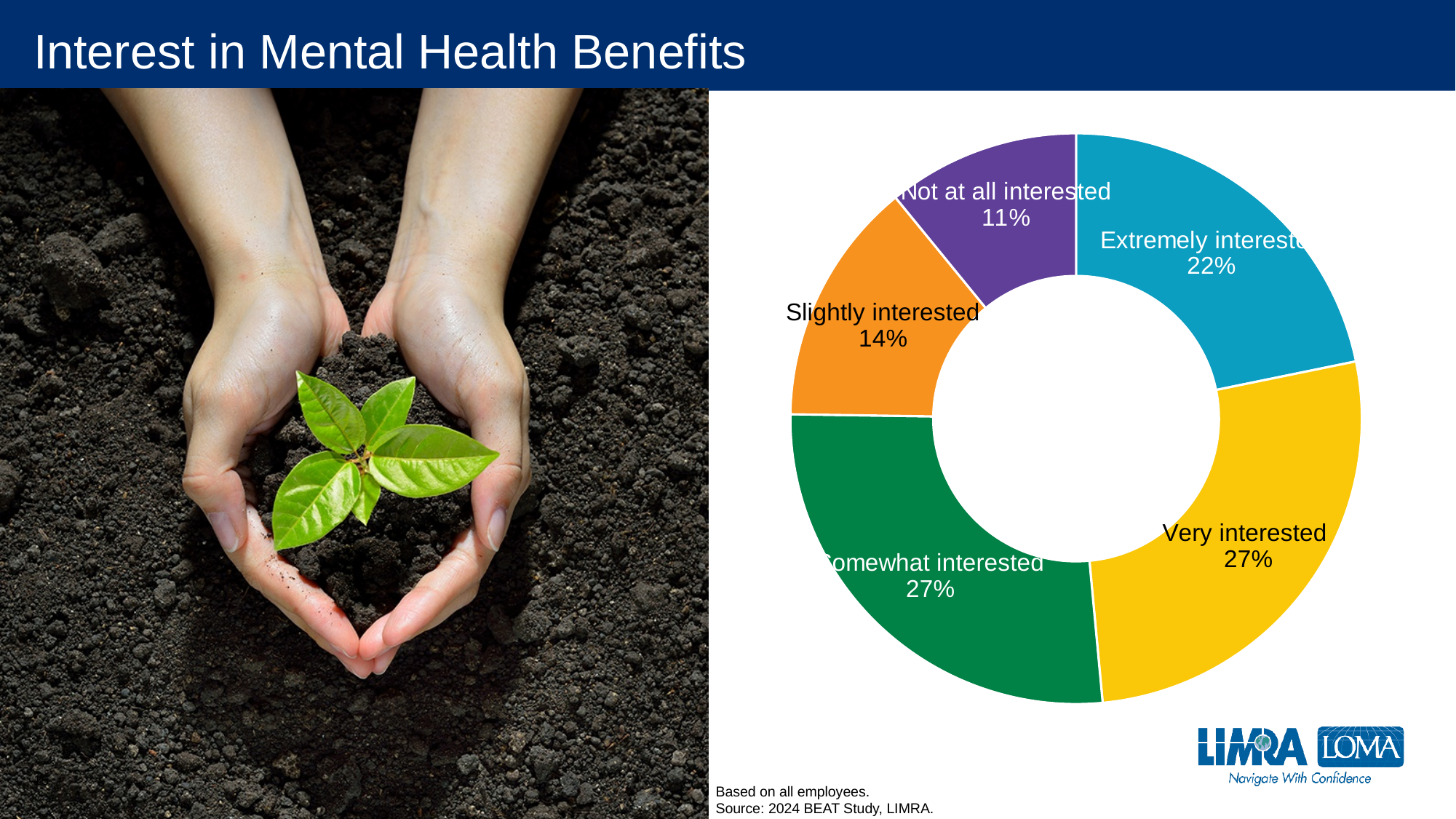
What percentage of employees are very interested in mental health benefits? 27% What is the difference in percentage points between Slightly interested and Not at all interested? 3 What colour is the Somewhat interested segment? Green What is the difference in percentage points between Very interested and Extremely interested? 5 What is the combined share of employees who are extremely or very interested? 49% What kind of chart is shown on the slide? Donut (pie) chart What percentage of employees are slightly interested in mental health benefits? 14% What percentage of employees are extremely interested in mental health benefits? 22% What percentage of employees are not at all interested in mental health benefits? 11% How many categories are shown in the chart? 5 Which category has the smallest share of the chart? Not at all interested Which is larger, the share for Extremely interested or the share for Slightly interested? Extremely interested